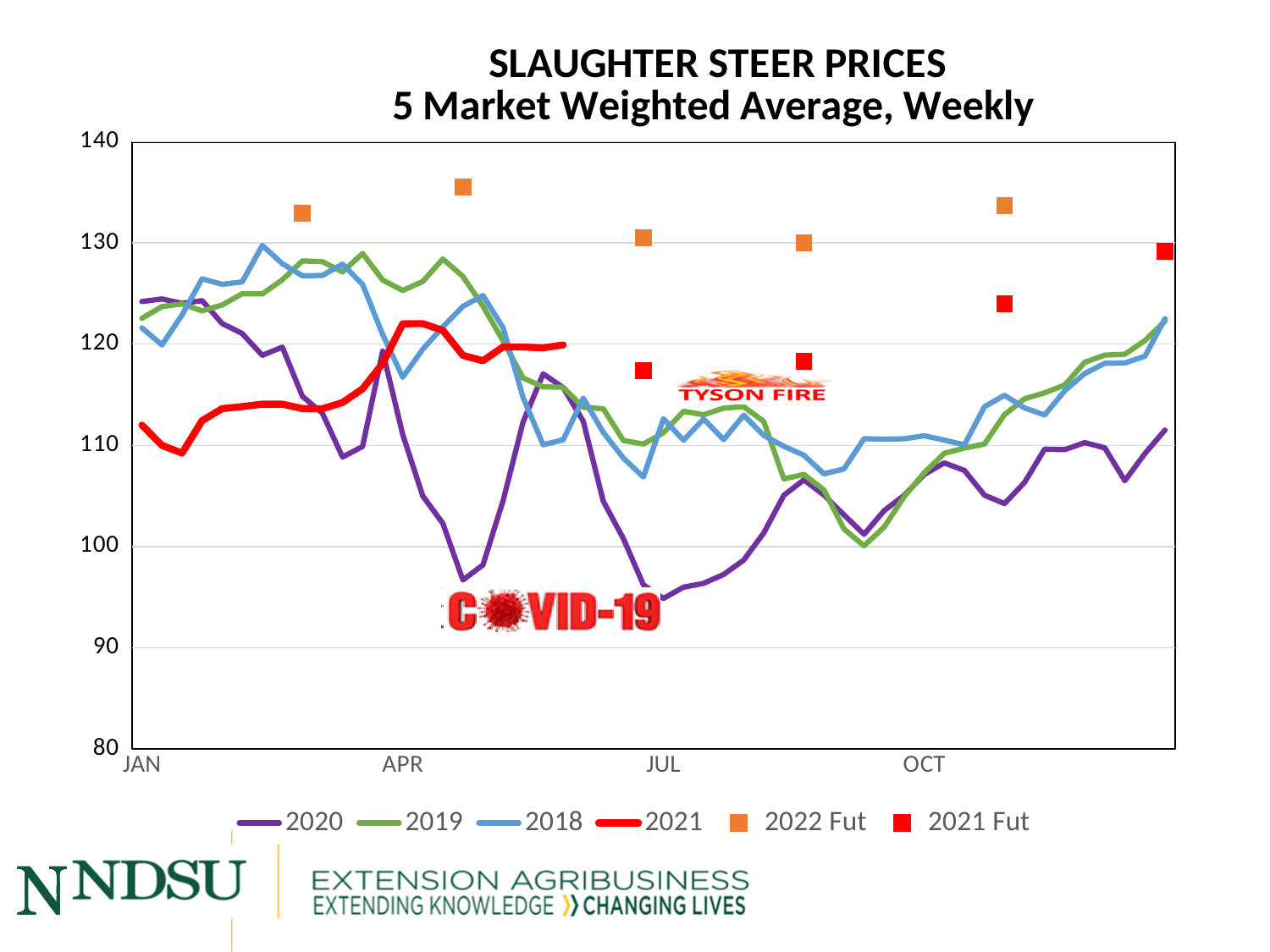
Does the 2021 line rise or fall from JAN to its last plotted point? rise Is the first 2022 Fut marker (near March) greater or less than 130? greater What is the title of the chart? SLAUGHTER STEER PRICES 5 Market Weighted Average, Weekly What kind of chart is shown on the slide? line chart At JAN, which series has the higher value, 2020 or 2021? 2020 At the end of the year, which series is higher, 2018 or 2020? 2018 Is the value of the 2021 line at JAN greater or less than 120? less How many series does the legend list? 6 Which futures series has the higher markers, 2022 Fut or 2021 Fut? 2022 Fut Is the lowest value of the 2020 line greater or less than 100? less Which series is shown with orange square markers? 2022 Fut